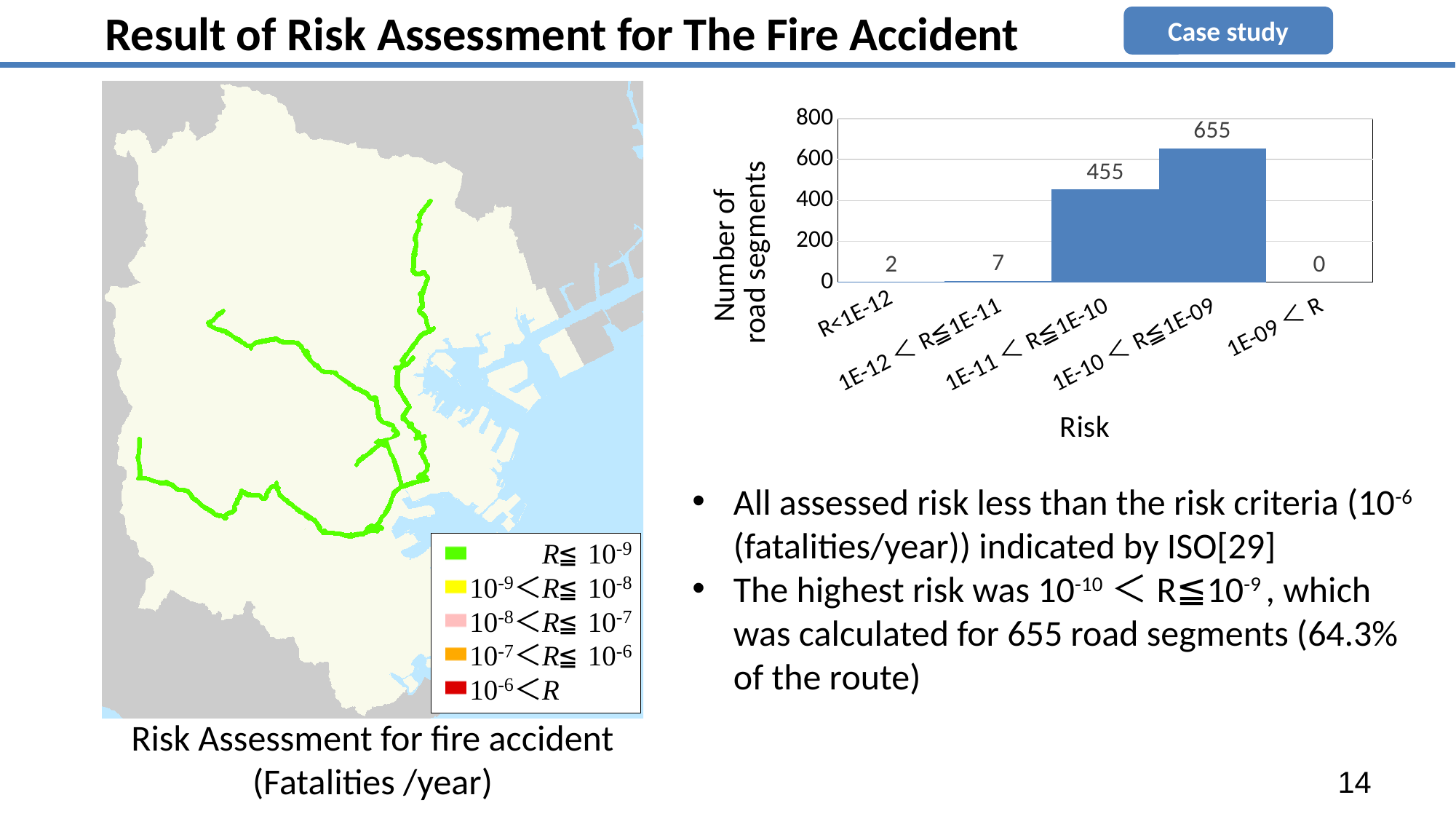
What is the number of road segments for the category 1E-09 < R? 0 Which risk category has the highest number of road segments? 1E-10 < R≦1E-09 What is the difference in road segments between the 1E-10 < R≦1E-09 category and the 1E-11 < R≦1E-10 category? 200 Which has more road segments: 1E-12 < R≦1E-11 or R<1E-12? 1E-12 < R≦1E-11 What is the number of road segments for the category R<1E-12? 2 Is the value for 1E-11 < R≦1E-10 greater or less than 400? greater Which risk category has the lowest number of road segments? 1E-09 < R What is the number of road segments for the category 1E-11 < R≦1E-10? 455 What is the label of the vertical axis of the bar chart? Number of road segments What is the number of road segments for the category 1E-10 < R≦1E-09? 655 How many risk categories are shown on the x axis of the bar chart? 5 What kind of chart is used to show the number of road segments by risk? bar chart